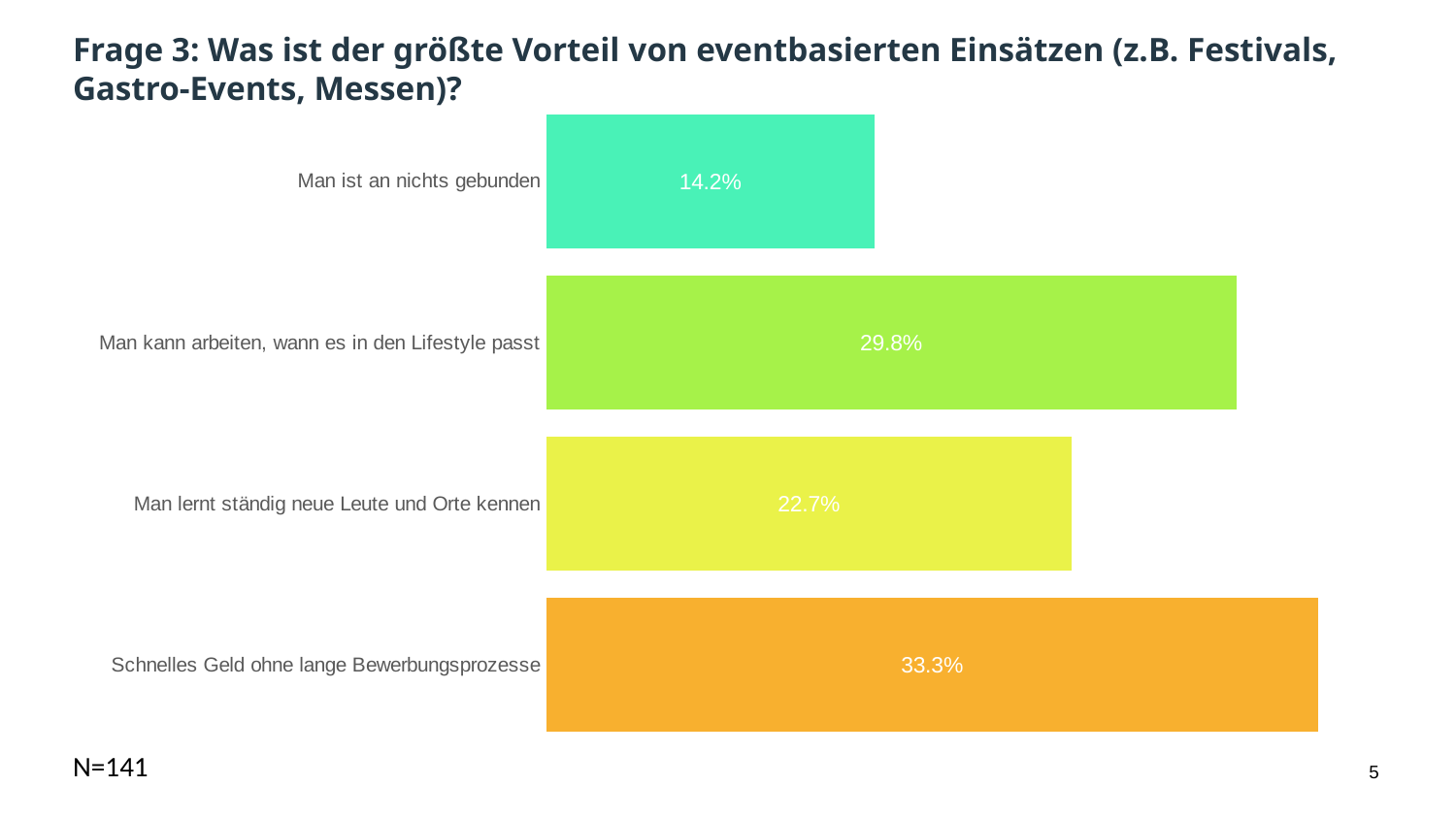
What is the value for "Schnelles Geld ohne lange Bewerbungsprozesse"? 33.3% How many categories are shown in the chart? 4 What is the difference between the values for "Man kann arbeiten, wann es in den Lifestyle passt" and "Man lernt ständig neue Leute und Orte kennen"? 7.1% Which is larger: the value for "Man kann arbeiten, wann es in den Lifestyle passt" or for "Man lernt ständig neue Leute und Orte kennen"? Man kann arbeiten, wann es in den Lifestyle passt What is the value for "Man ist an nichts gebunden"? 14.2% What is the value for "Man kann arbeiten, wann es in den Lifestyle passt"? 29.8% What sample size (N) is stated on the slide? N=141 What kind of chart is shown on the slide? Bar chart Which category has the lowest value? Man ist an nichts gebunden Which category has the highest value? Schnelles Geld ohne lange Bewerbungsprozesse What is the value for "Man lernt ständig neue Leute und Orte kennen"? 22.7% What is the difference between the values for "Schnelles Geld ohne lange Bewerbungsprozesse" and "Man ist an nichts gebunden"? 19.1%